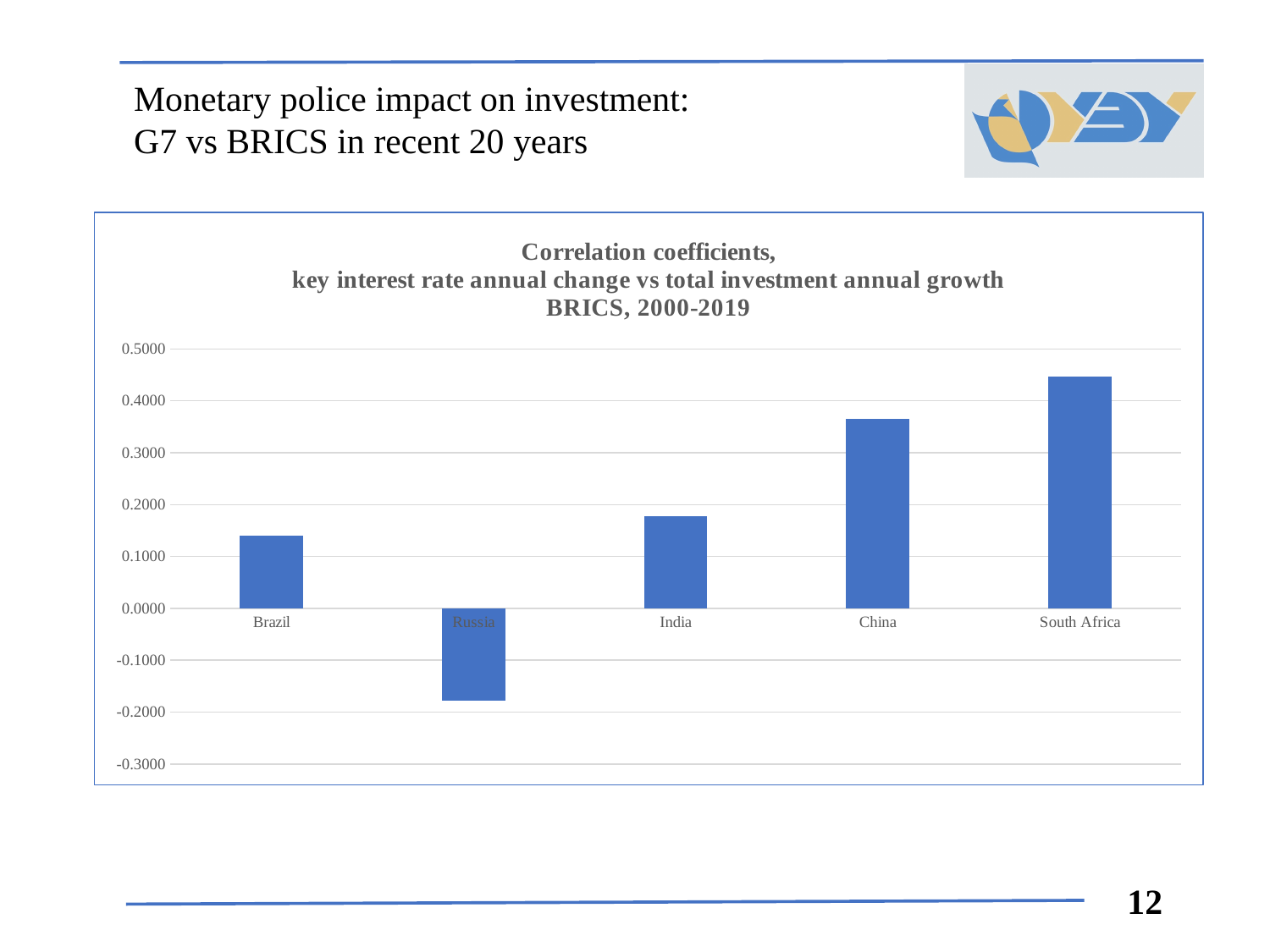
Is the value for South Africa greater or less than 0.4000? greater Is the value for China greater or less than 0.3000? greater Which country is the only one with a negative correlation coefficient? Russia Is the value for Brazil greater or less than 0.1000? greater Which country has the highest correlation coefficient in the chart? South Africa Which period does the chart title say the correlation coefficients cover? 2000-2019 Which has a larger correlation coefficient, China or India? China Which country has the lowest correlation coefficient in the chart? Russia What type of chart is shown on the slide? bar chart How many countries are shown on the x axis of the chart? 5